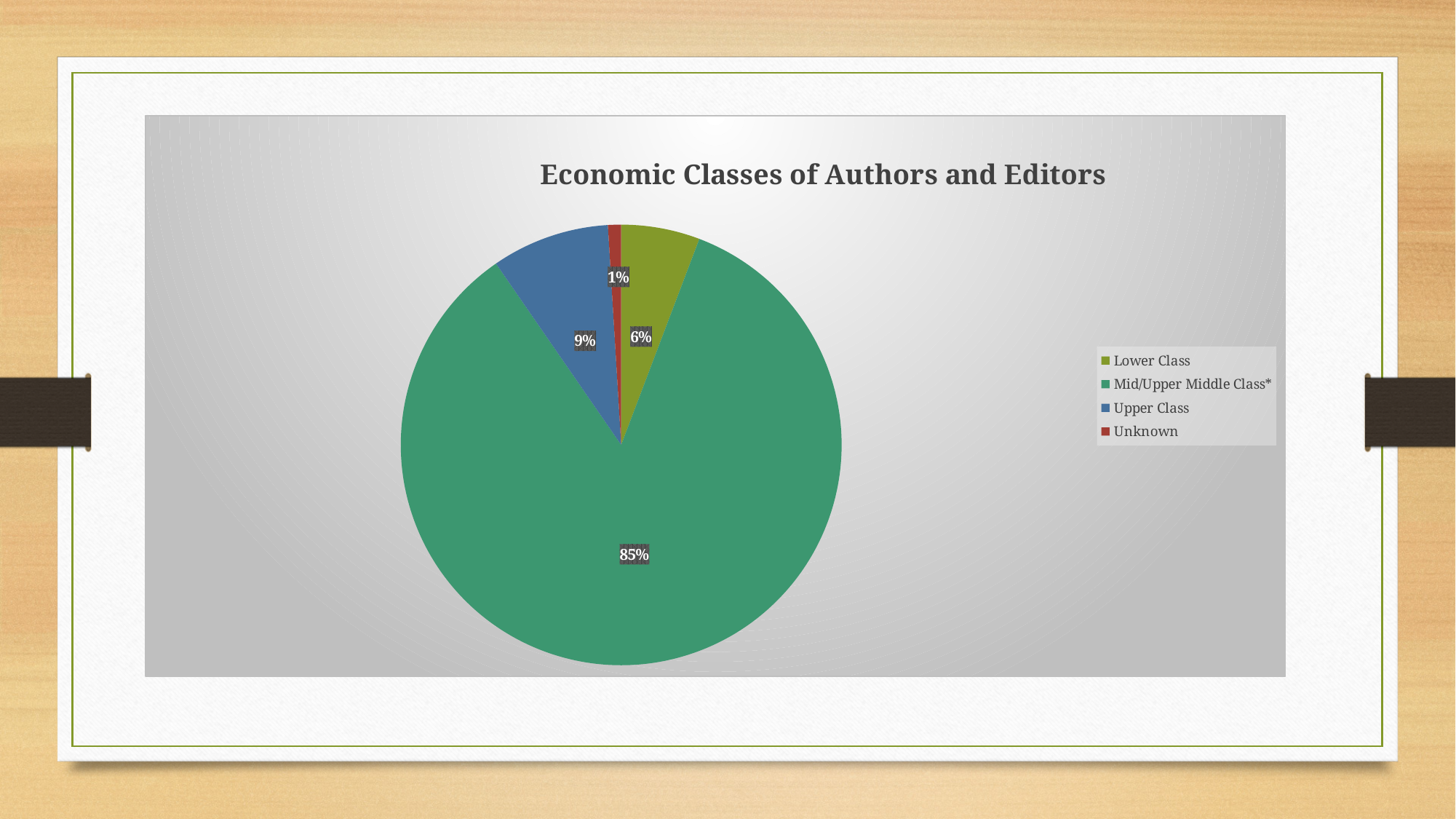
What is the title of the chart? Economic Classes of Authors and Editors What percentage of the pie is Upper Class? 9% Which category has the largest share of the pie? Mid/Upper Middle Class* What is the difference in percentage points between the Mid/Upper Middle Class* share and the Upper Class share? 76 Which category has the smallest share of the pie? Unknown What percentage of the pie is Unknown? 1% What percentage of the pie is Mid/Upper Middle Class*? 85% Which is larger, the share for Upper Class or the share for Lower Class? Upper Class What percentage of the pie is Lower Class? 6% What colour is the Upper Class slice? blue How many categories does the legend list? 4 What type of chart is shown on the slide? pie chart